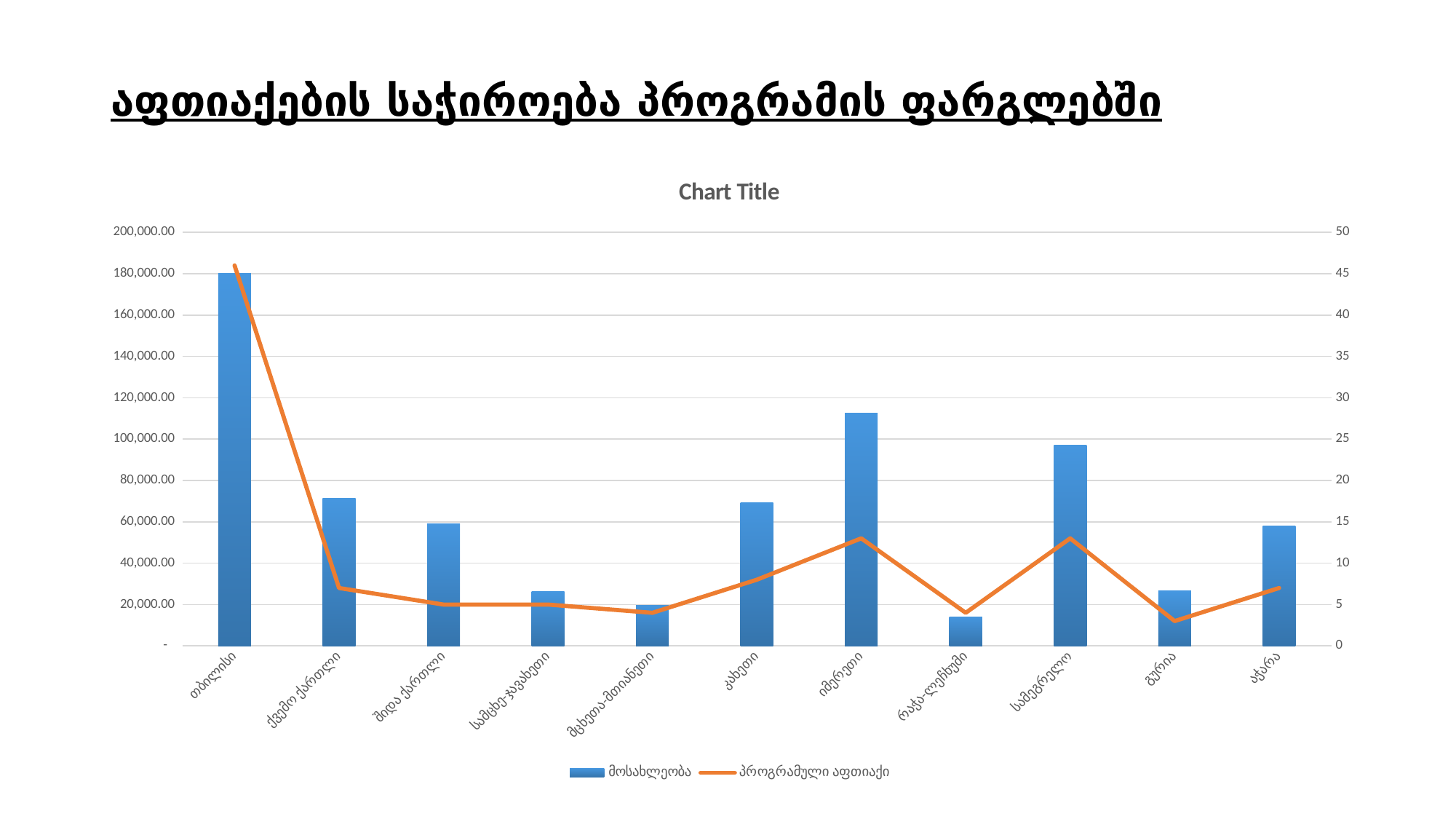
How many series does the legend list? 2 Is the მოსახლეობა bar for რაჭა-ლეჩხუმი greater or less than 20,000.00? less Is the მოსახლეობა bar for თბილისი greater or less than 160,000.00? greater Is the მოსახლეობა bar for იმერეთი greater or less than 100,000.00? greater Which has the larger მოსახლეობა bar, იმერეთი or სამეგრელო? იმერეთი What title is displayed above the chart? Chart Title How many categories are shown along the x axis? 11 Which category has the highest bar for მოსახლეობა? თბილისი What kind of chart is shown on the slide? A combined bar and line chart Which category has the lowest bar for მოსახლეობა? რაჭა-ლეჩხუმი Which category has the highest value on the პროგრამული აფთიაქი line? თბილისი